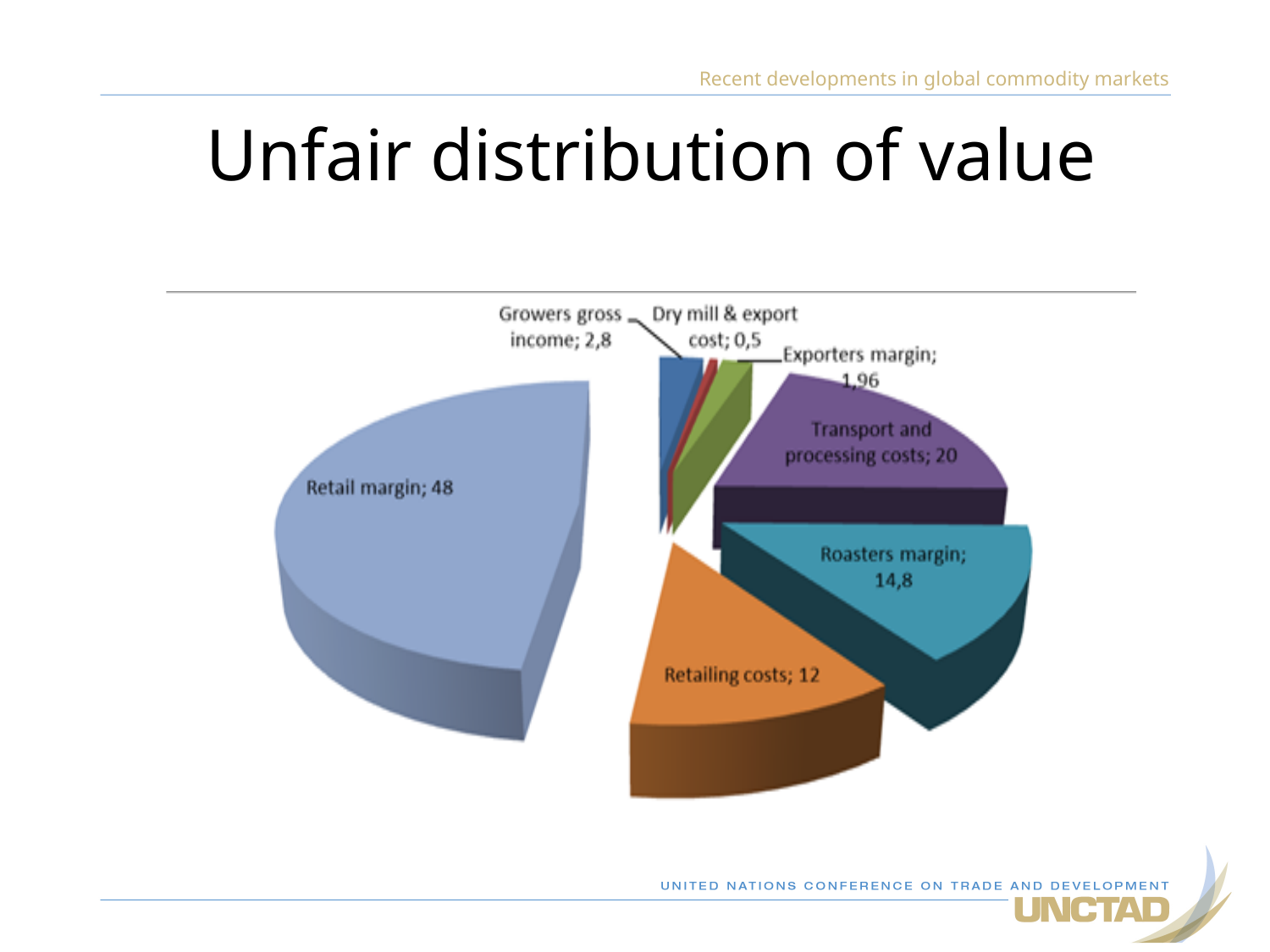
What is the difference between the values for Roasters margin and Retailing costs? 2,8 What value is shown for Roasters margin? 14,8 What value is shown for Growers gross income? 2,8 What kind of chart is shown on the slide? Pie chart Which category has the largest slice of the pie? Retail margin Which is larger, Roasters margin or Retailing costs? Roasters margin How many slices does the pie chart have? 7 What is the difference between the values for Retail margin and Transport and processing costs? 28 Which category has the smallest slice of the pie? Dry mill & export cost What value is shown for Exporters margin? 1,96 What value is shown for Transport and processing costs? 20 What value is shown for Retail margin? 48